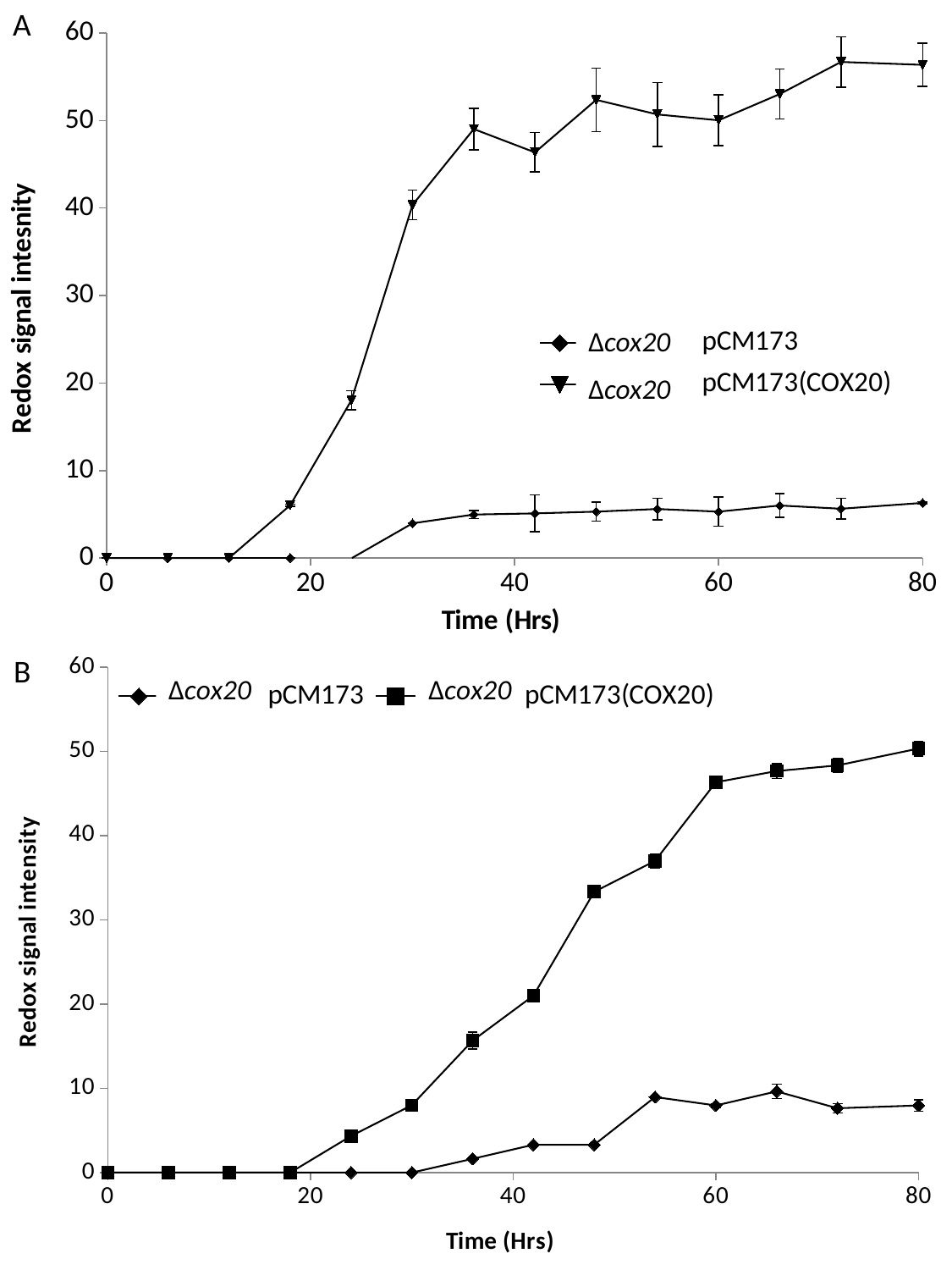
In chart B, what marker shape is used for the Δcox20 pCM173(COX20) series? square In chart B, is the value for Δcox20 pCM173 at 80 hours greater or less than 10? less What is the x-axis title of chart B? Time (Hrs) In chart A, is the value for Δcox20 pCM173 at 80 hours greater or less than 10? less In chart A, is the value for Δcox20 pCM173(COX20) at 80 hours greater or less than 50? greater In chart B, how many series does the legend list? 2 What kind of chart is chart A? line chart In chart A, how many series does the legend list? 2 In chart A, what is the redox signal intensity for Δcox20 pCM173(COX20) at time 0? 0 In chart A, which series has the higher value at 60 hours? Δcox20 pCM173(COX20) In chart B, does the Δcox20 pCM173(COX20) series rise or fall as time increases? rise